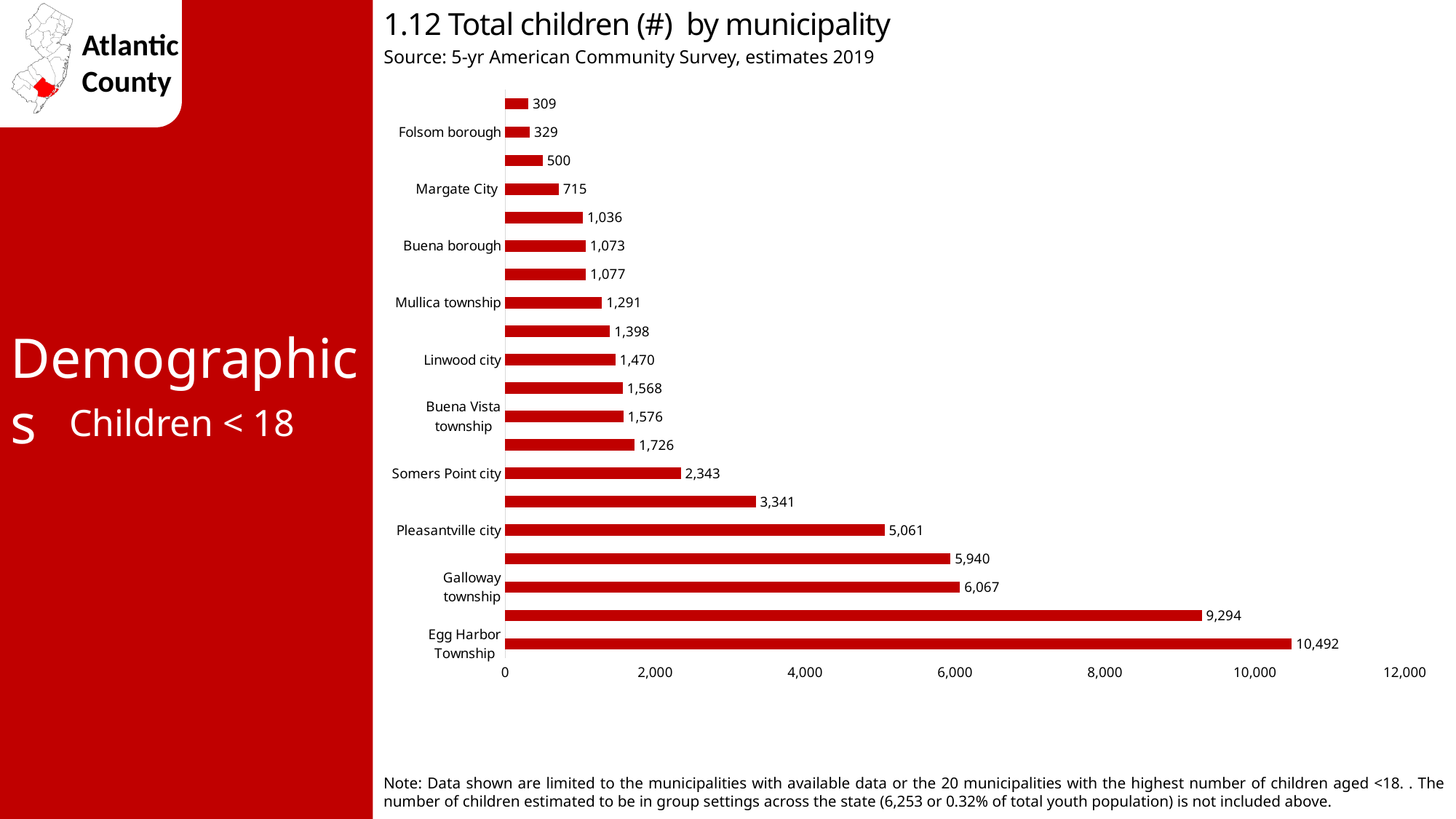
What is the smallest value shown on the chart? 309 Is the value for Pleasantville city greater or less than 4,000? greater What is the value for Folsom borough? 329 What is the difference between the values for Margate City and Folsom borough? 386 Which municipality has the highest number of children? Egg Harbor Township What is the value for Pleasantville city? 5,061 What is the value for Somers Point city? 2,343 Which is larger, the value for Linwood city or the value for Mullica township? Linwood city What is the value for Egg Harbor Township? 10,492 What is the difference between the values for Egg Harbor Township and Galloway township? 4,425 How many bars are shown on the chart? 20 What kind of chart is shown on the slide? bar chart